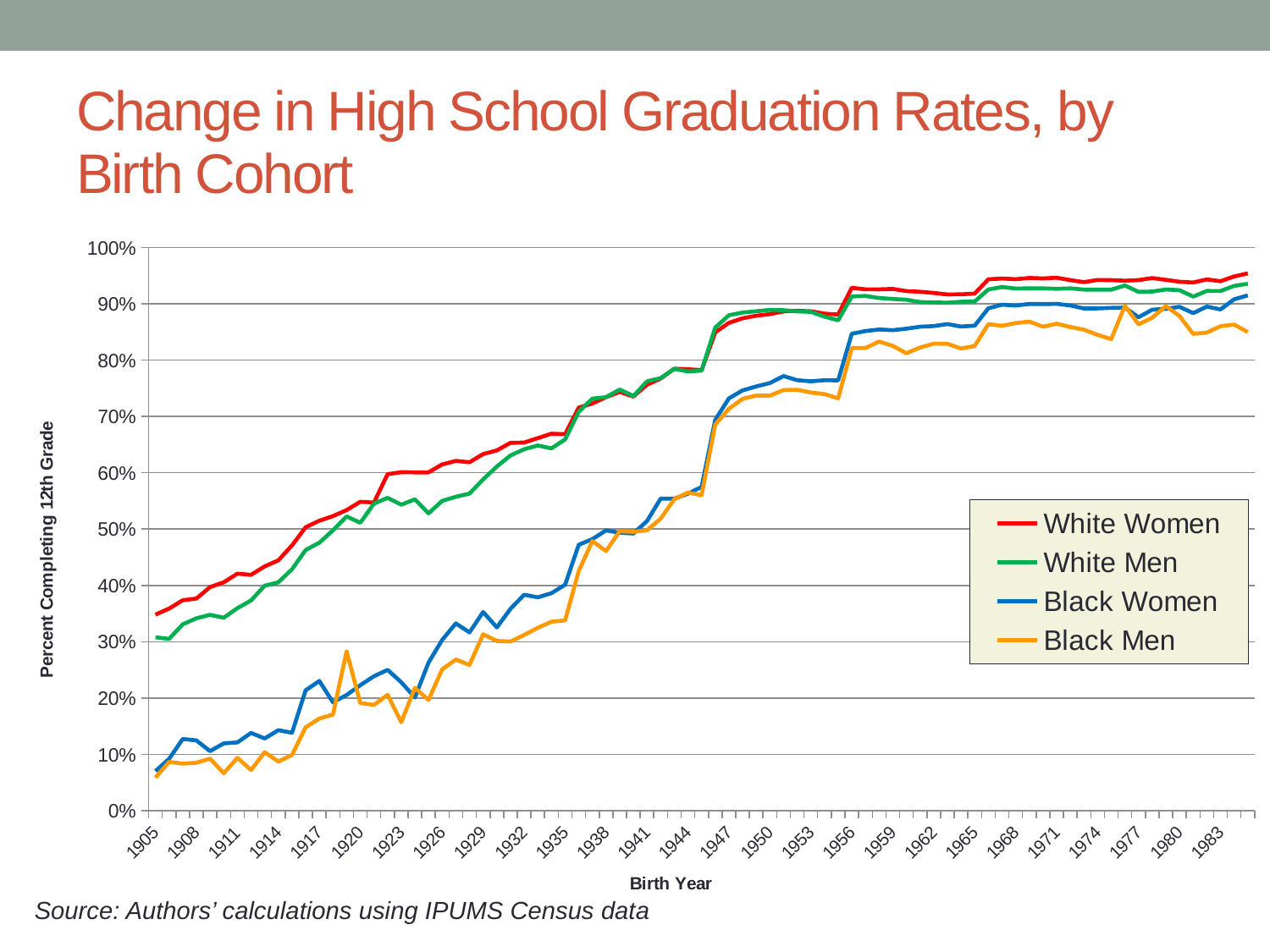
Do the graduation rates generally rise or fall as birth year increases along the x axis? rise Which series has the highest value at birth year 1905? White Women Is the value for Black Women at birth year 1947 greater or less than 70%? greater At birth year 1935, which is higher: White Men or Black Men? White Men What is the label on the vertical axis? Percent Completing 12th Grade Is the value for Black Men at birth year 1905 greater or less than 10%? less Is the value for Black Men at birth year 1983 greater or less than 90%? less What kind of chart is shown on the slide? line chart How many series does the legend list? 4 What colour is the line for Black Men? orange